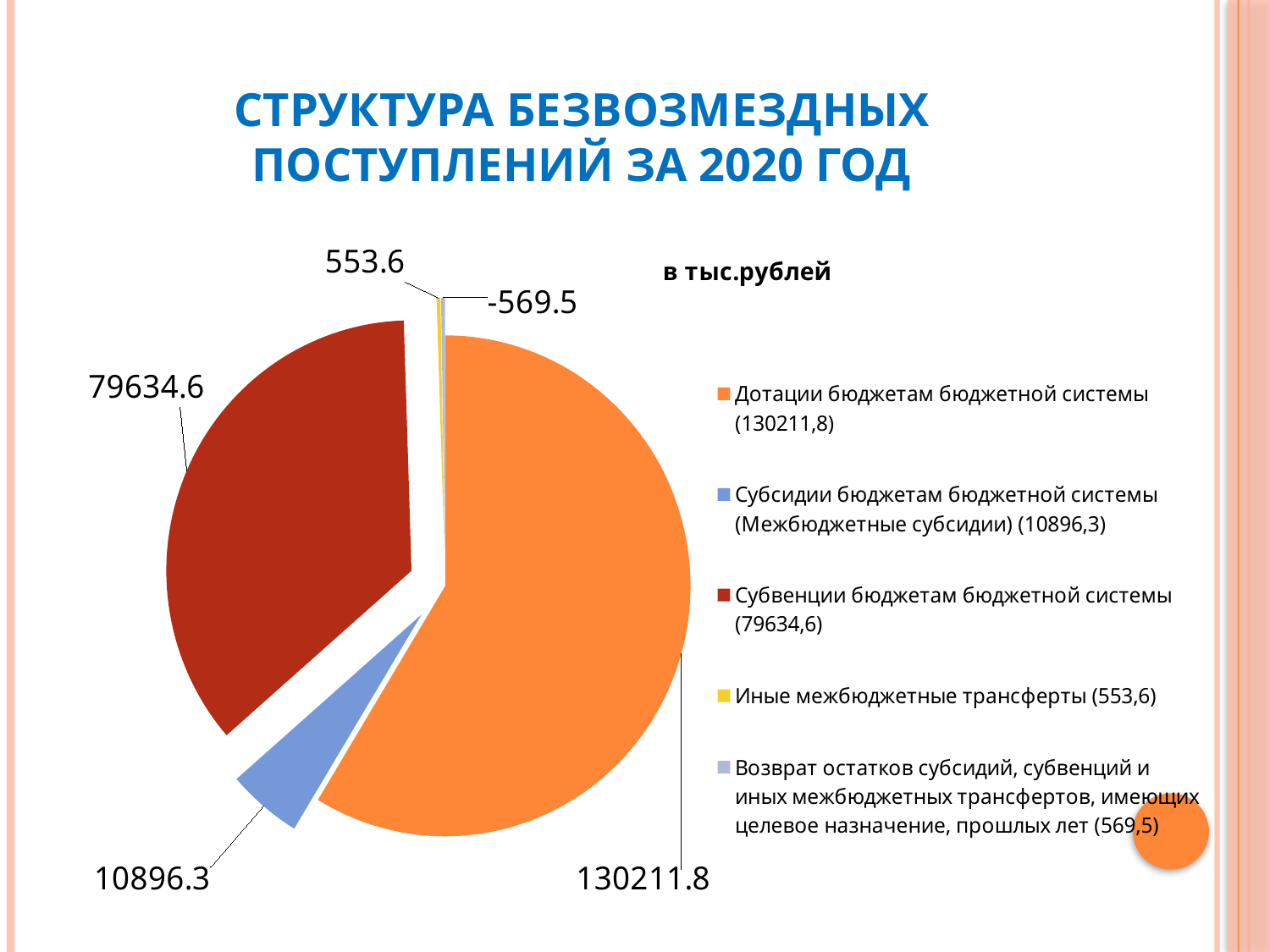
Which category has the lowest value in the pie chart? Возврат остатков субсидий, субвенций и иных межбюджетных трансфертов, имеющих целевое назначение, прошлых лет What kind of chart is shown on the slide? pie chart What is the value for Субвенции бюджетам бюджетной системы? 79634.6 Which category has the highest value in the pie chart? Дотации бюджетам бюджетной системы What is the value for Дотации бюджетам бюджетной системы? 130211.8 How many categories does the legend of the pie chart list? 5 What is the value for Иные межбюджетные трансферты? 553.6 What is the value for Возврат остатков субсидий, субвенций и иных межбюджетных трансфертов, имеющих целевое назначение, прошлых лет? -569.5 In what units are the values on the chart given, according to the label next to the chart? в тыс.рублей What is the value for Субсидии бюджетам бюджетной системы (Межбюджетные субсидии)? 10896.3 What is the difference between the values for Дотации бюджетам бюджетной системы and Субвенции бюджетам бюджетной системы? 50577.2 Which is larger: Субвенции бюджетам бюджетной системы or Субсидии бюджетам бюджетной системы? Субвенции бюджетам бюджетной системы